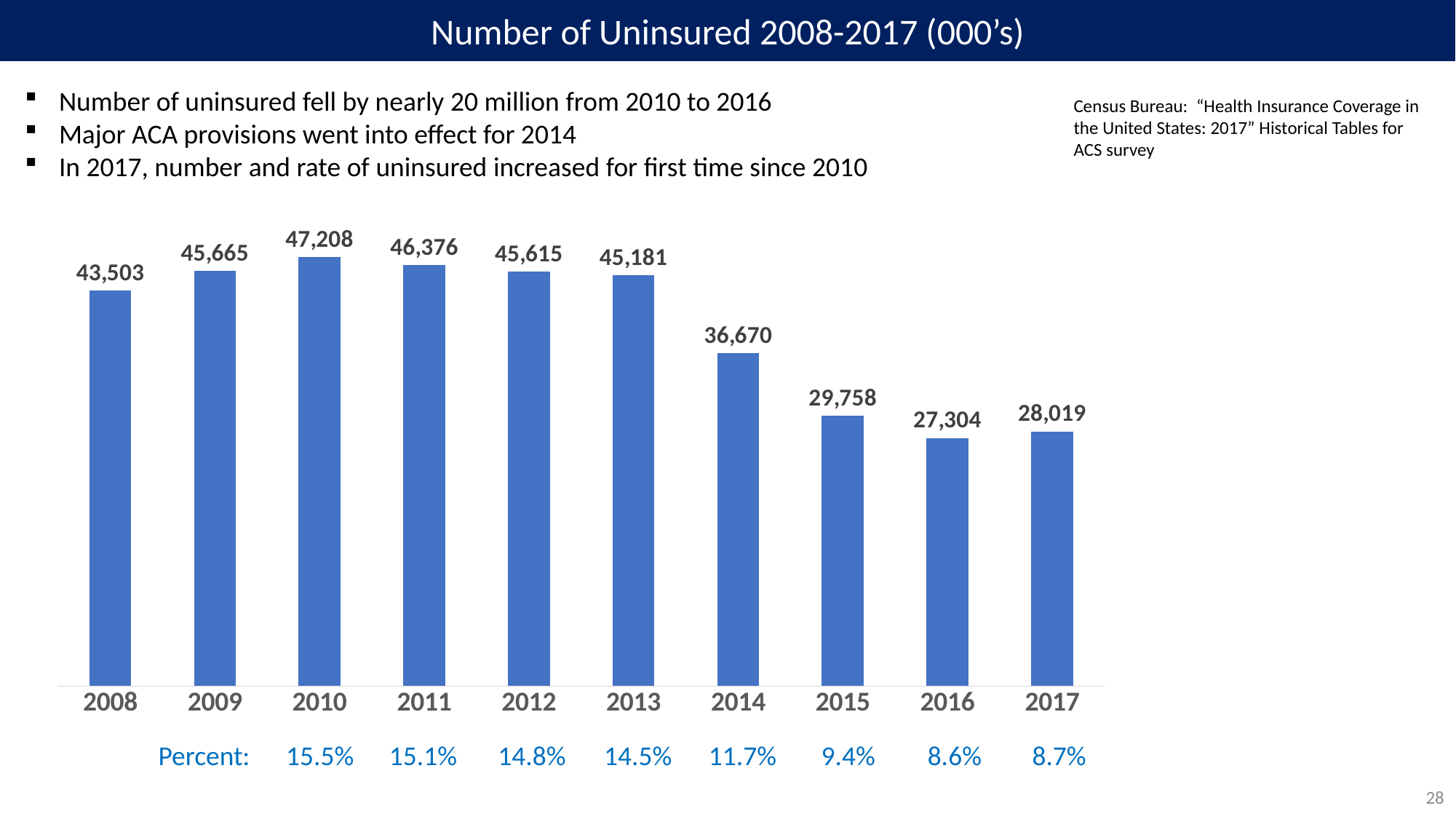
What is the difference between the 2013 and 2014 values in the chart? 8,511 What is the number of uninsured (000's) shown for 2014? 36,670 What type of chart is shown on the slide? Bar chart What is the number of uninsured (000's) shown for 2017? 28,019 What is the difference between the 2010 and 2016 values in the chart? 19,904 Do the values in the chart generally rise or fall from 2010 to 2016? Fall What is the number of uninsured (000's) shown for 2010? 47,208 What is the title of the chart on the slide? Number of Uninsured 2008-2017 (000's) How many years are shown as bars in the chart? 10 Which year has a larger number of uninsured, 2009 or 2011? 2011 Which year has the highest number of uninsured in the chart? 2010 Which year has the lowest number of uninsured in the chart? 2016